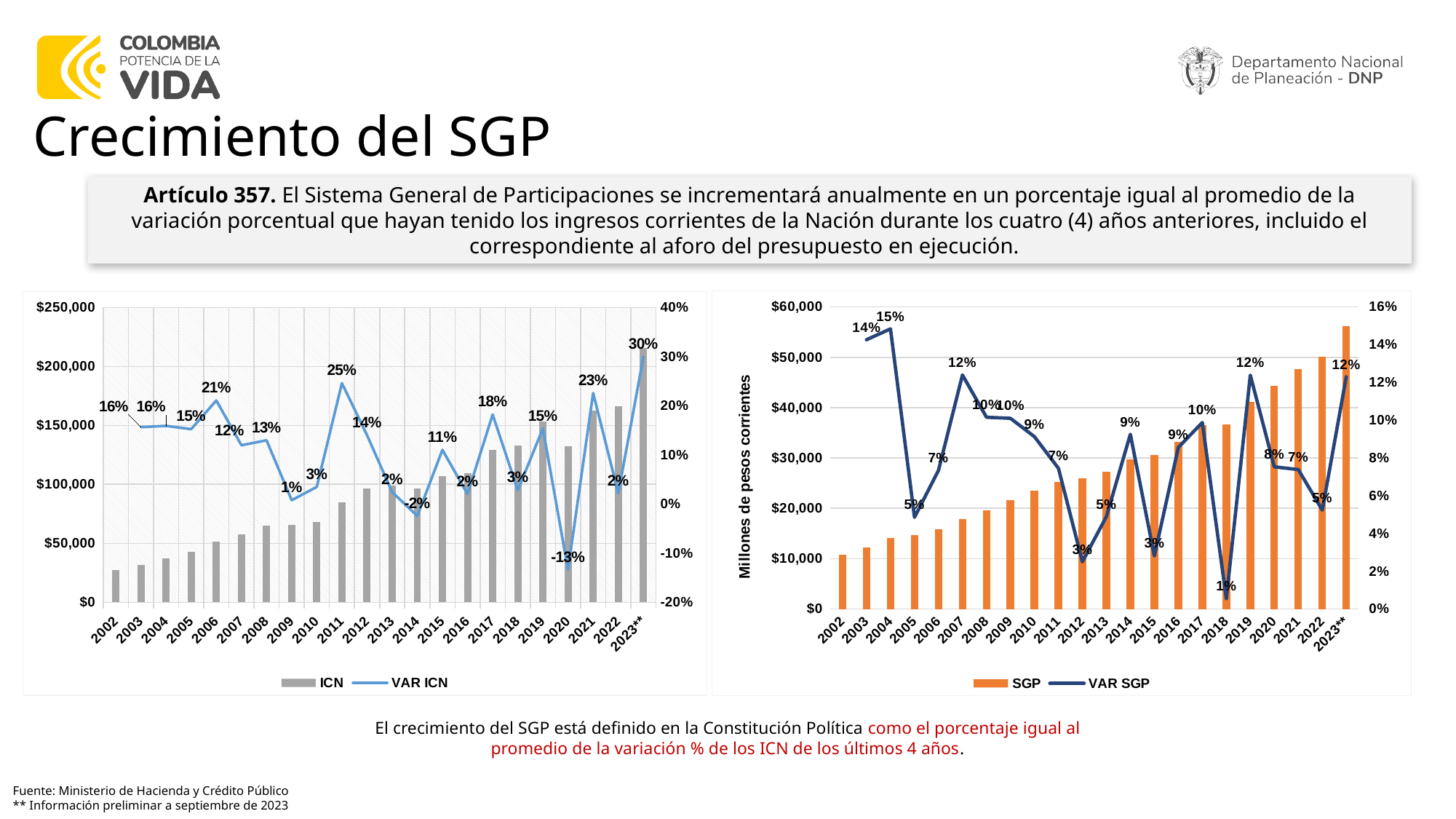
In the right chart, is the SGP bar for 2023** greater or less than $50,000? greater In the left chart, what is the VAR ICN value for 2020? -13% In the left chart, what is the VAR ICN value for 2011? 25% In the right chart, what is the VAR SGP value for 2018? 1% In the right chart, what is the VAR SGP value for 2007? 12% In the left chart, which year has the highest VAR ICN value? 2023** In the left chart, what is the difference between the VAR ICN values for 2021 and 2022? 21 percentage points In the right chart, which year has the lowest VAR SGP value? 2018 How many years are shown on the x axis of the right chart? 22 In the right chart, which is larger, the VAR SGP value for 2004 or for 2005? 2004 In the right chart, do the SGP bars rise or fall from 2002 to 2023**? rise How many series does the legend of the left chart list? 2